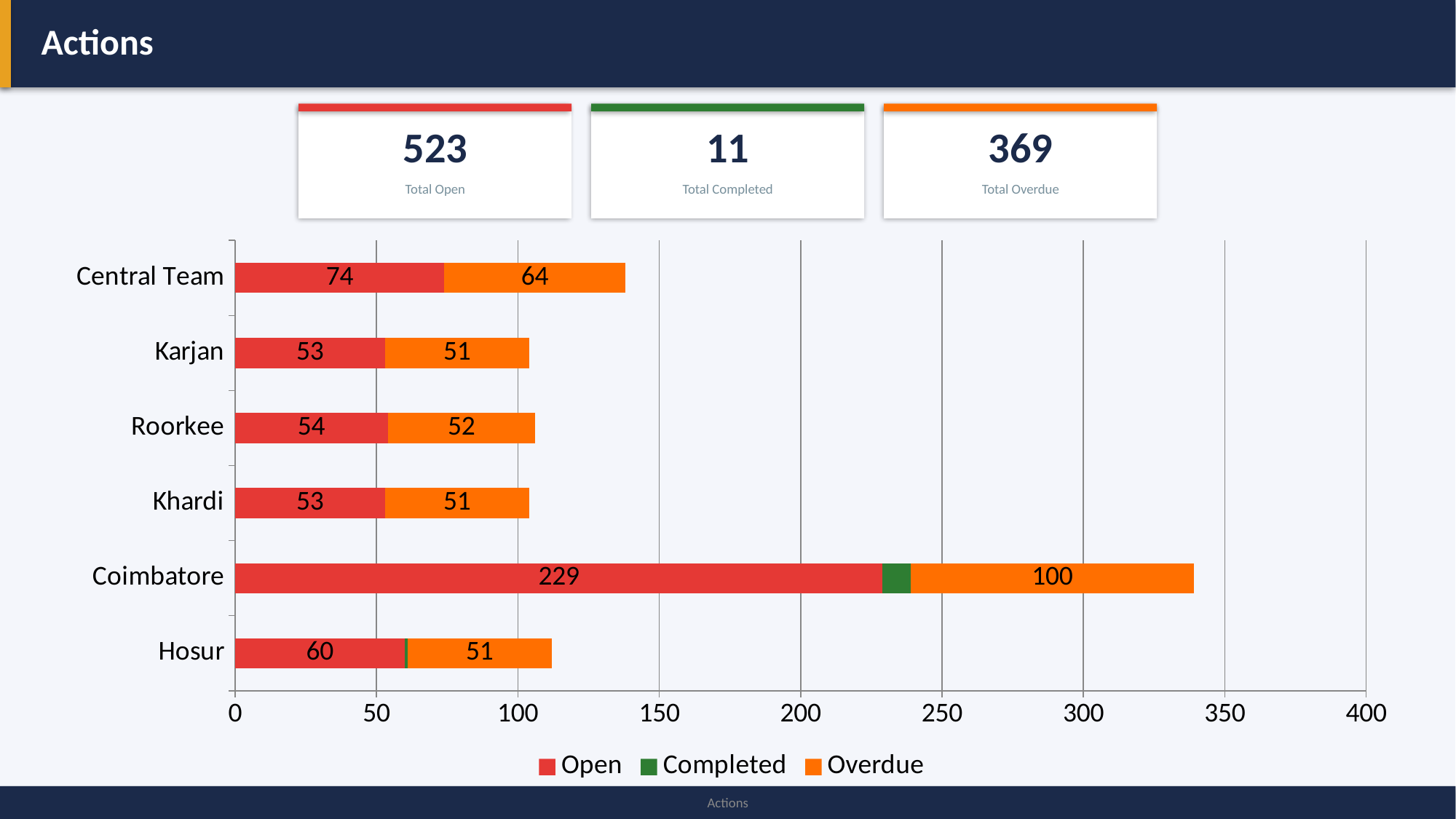
What type of chart is shown on the slide? Stacked bar chart Which category has the lowest Overdue value among Central Team, Roorkee and Coimbatore? Roorkee What is the difference between the Open and Overdue values for Coimbatore? 129 Which category has the highest Open value? Coimbatore What is the Open value for Coimbatore? 229 Which is larger, the Open value for Central Team or the Open value for Roorkee? Central Team What is the Open value for Hosur? 60 How many series does the legend list? 3 What is the total of the stacked bar for Central Team? 138 What is the Overdue value for Central Team? 64 How many categories are shown on the chart? 6 Which series is shown in green in the legend? Completed